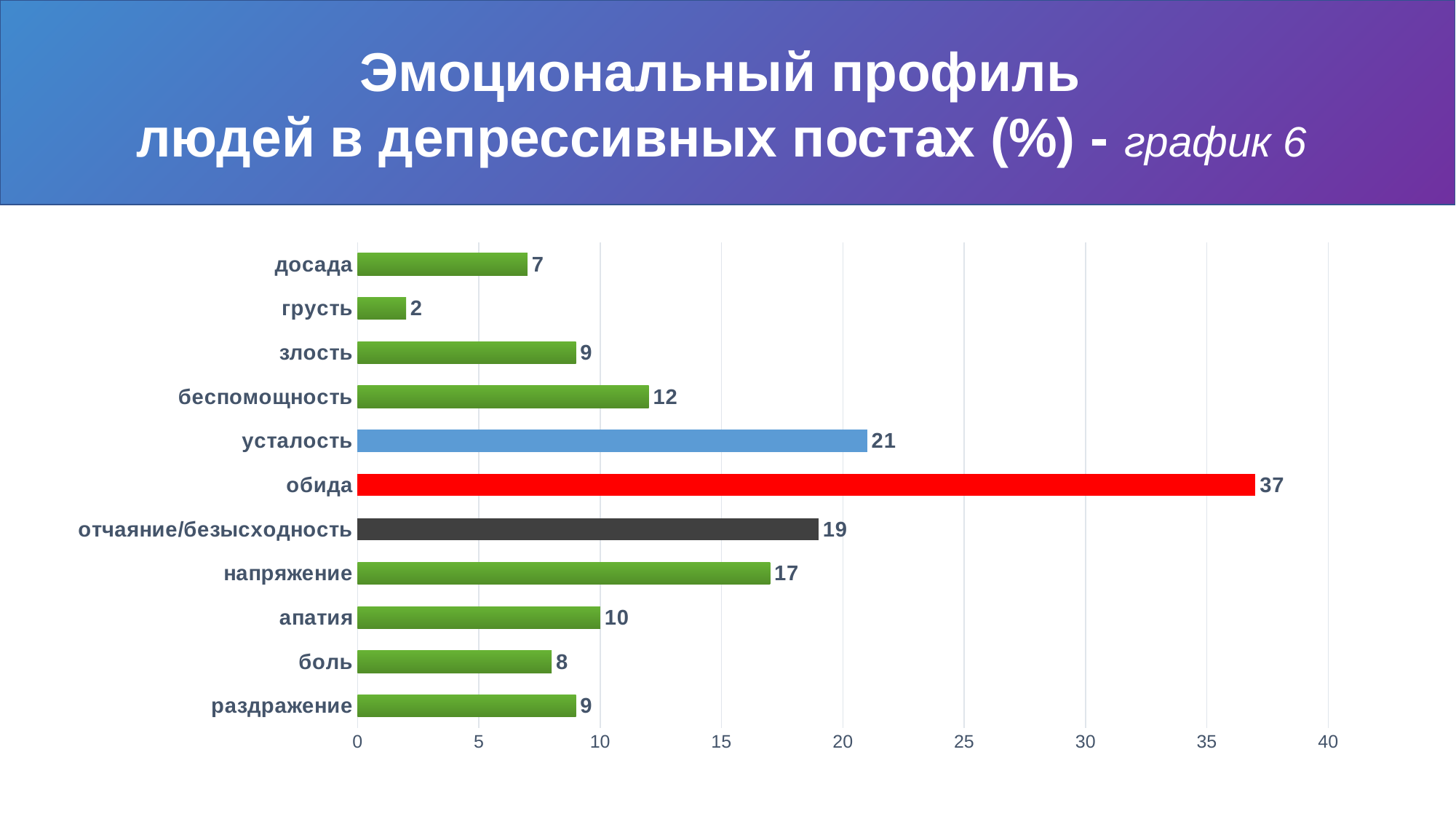
What is the difference between the values for обида and усталость? 16 Which category's bar is coloured red? обида Which category has the lowest value? грусть What kind of chart is shown on the slide? bar chart Is the value for апатия greater or less than 5? greater Which is larger, the value for напряжение or the value for беспомощность? напряжение What is the value for усталость? 21 What is the value for отчаяние/безысходность? 19 How many categories are shown in the chart? 11 What is the difference between the values for напряжение and боль? 9 Which category has the highest value? обида What is the value for обида? 37